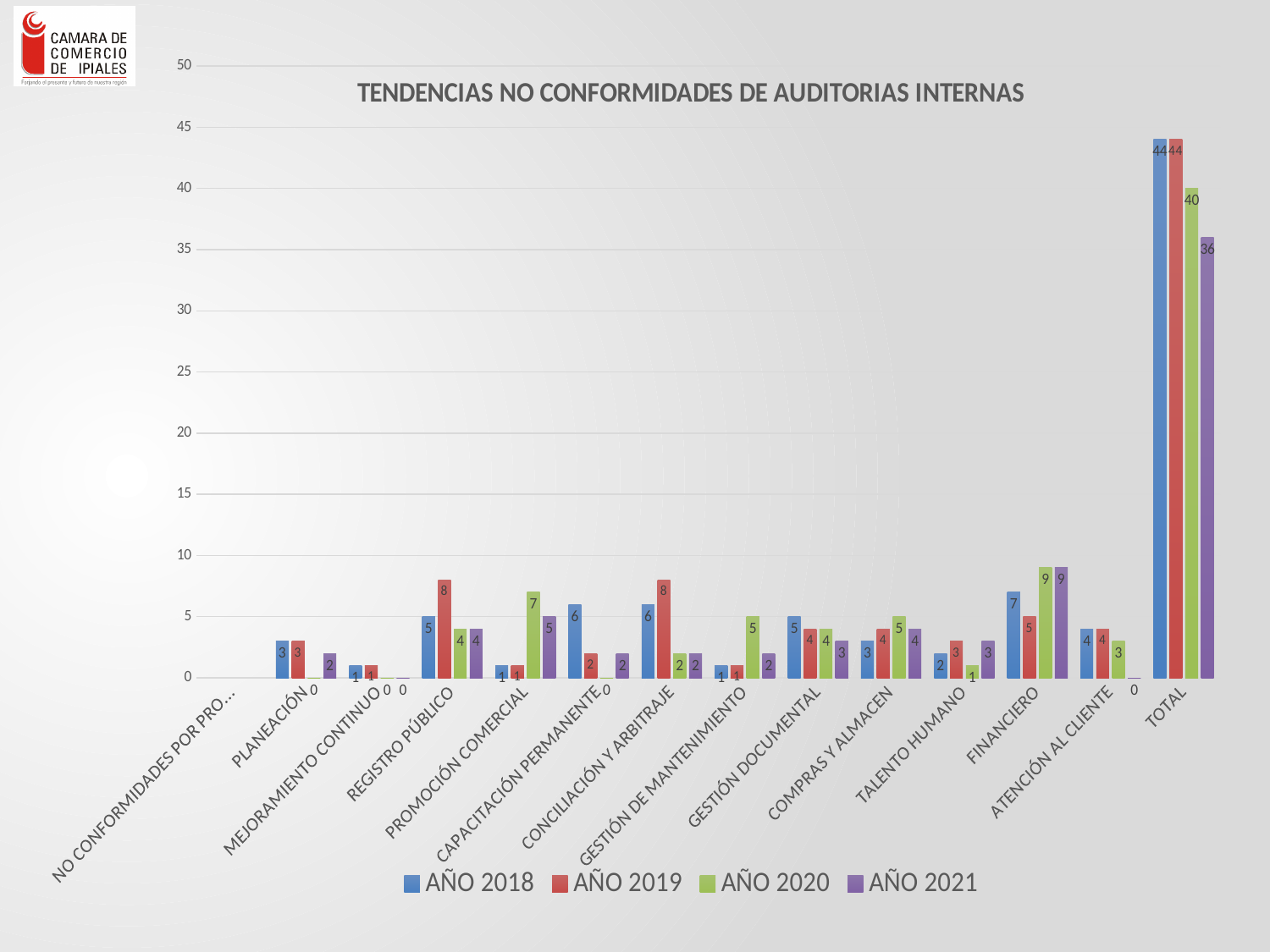
What kind of chart is shown on the slide? Bar chart What is the value for AÑO 2019 in the REGISTRO PÚBLICO category? 8 Which is larger in the CONCILIACIÓN Y ARBITRAJE category: the AÑO 2019 value or the AÑO 2020 value? AÑO 2019 Which colour represents AÑO 2020 in the chart? Green What is the value for AÑO 2018 in the FINANCIERO category? 7 What is the value for AÑO 2021 in the TOTAL category? 36 Is the AÑO 2020 value for TOTAL greater or less than 35? greater How many series does the legend list? 4 What is the value for AÑO 2020 in the PROMOCIÓN COMERCIAL category? 7 Which series has the lowest value in the TOTAL category? AÑO 2021 What is the title of the chart? TENDENCIAS NO CONFORMIDADES DE AUDITORIAS INTERNAS What is the difference between the AÑO 2018 and AÑO 2020 values in the TOTAL category? 4